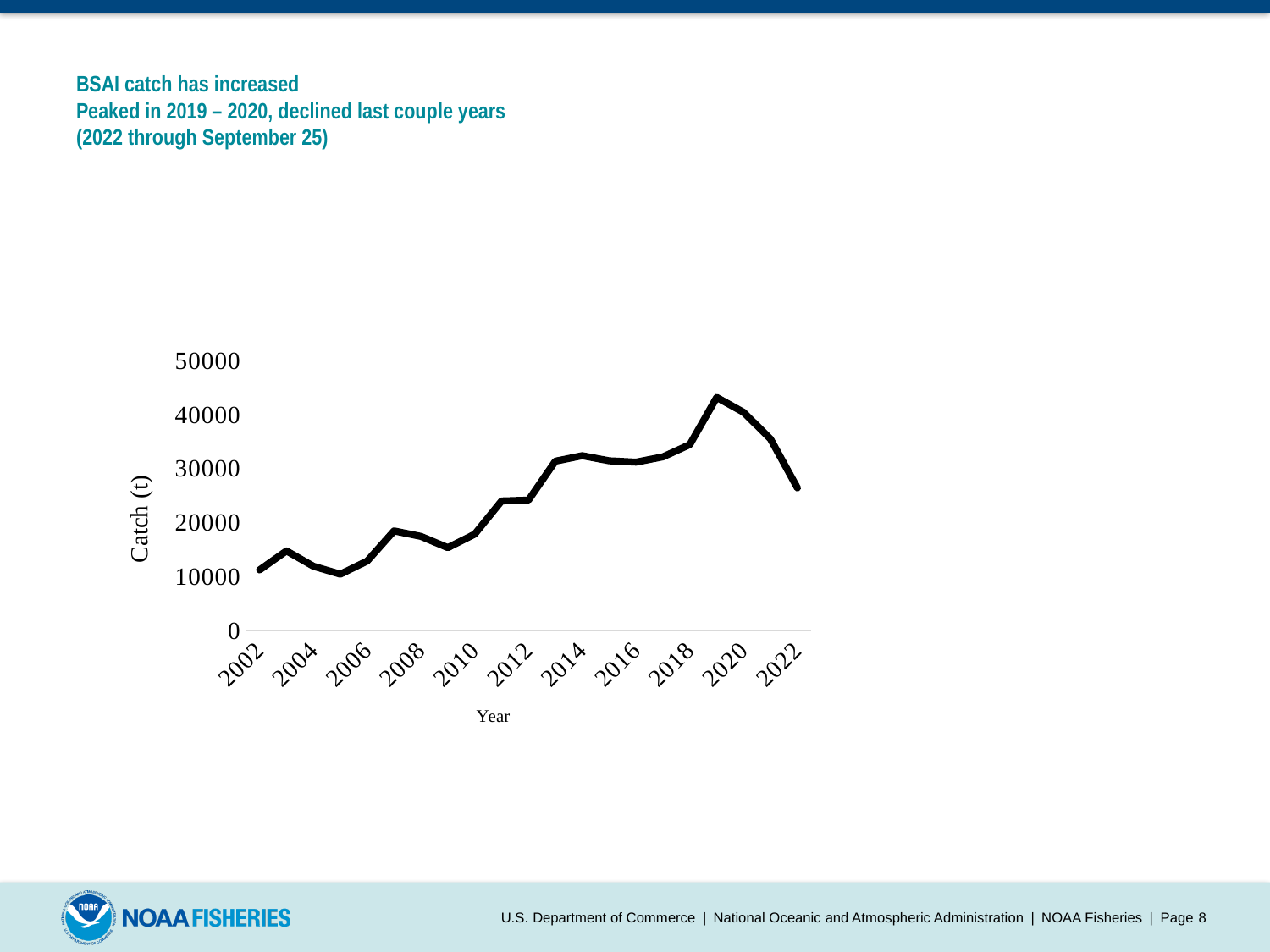
In which year does the catch reach its highest value on the chart? 2019 What is the label of the vertical axis of the chart? Catch (t) What kind of chart is shown on the slide? line chart Does the catch rise or fall between 2019 and 2022? fall Is the catch value for 2012 greater or less than 20000? greater Which year has the larger catch, 2002 or 2019? 2019 Is the catch value for 2022 greater or less than 30000? less Is the catch value for 2019 greater or less than 40000? greater What is the label of the horizontal axis of the chart? Year What is the highest value shown on the vertical axis of the chart? 50000